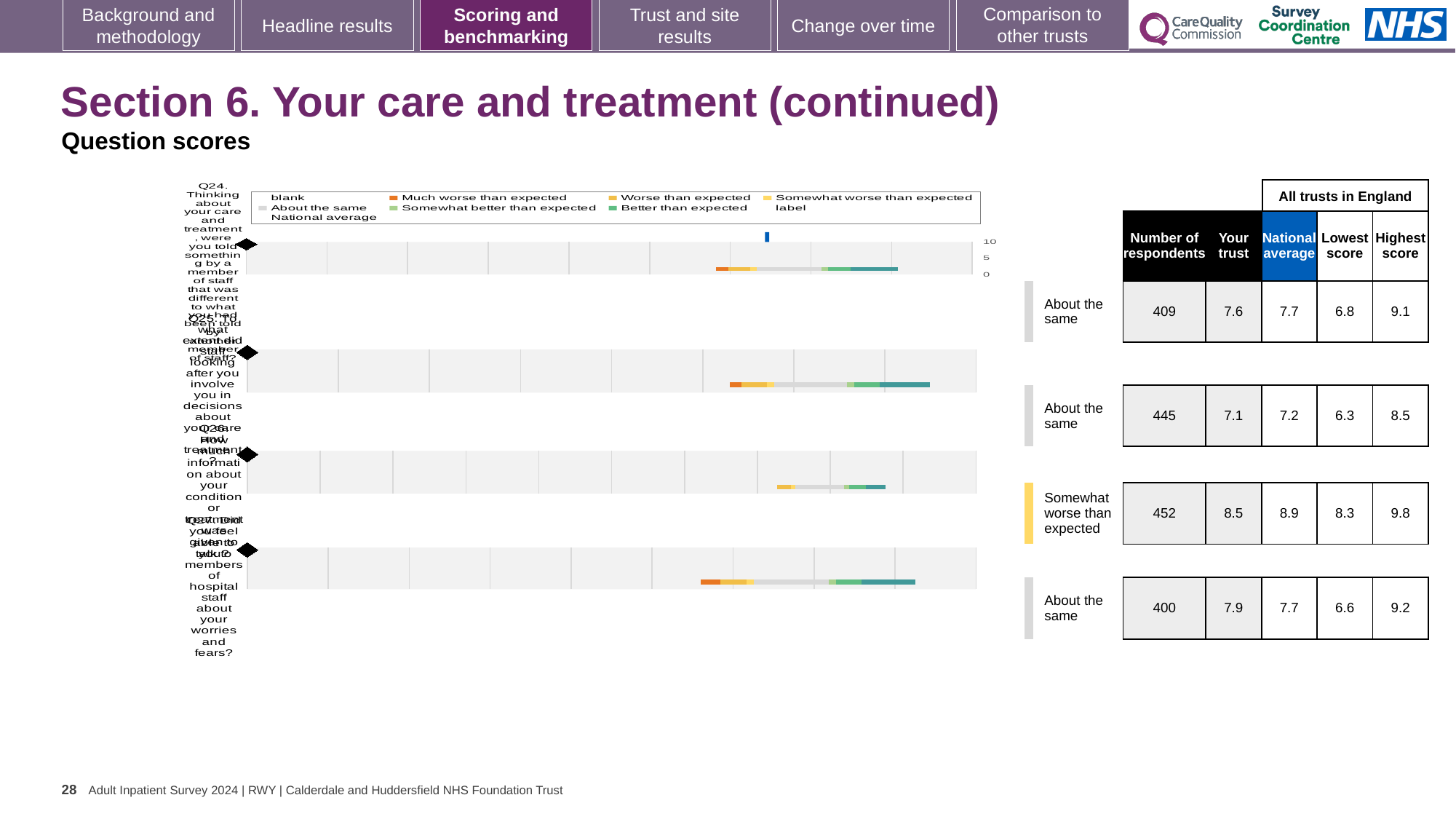
Which question has the lowest number of respondents on this slide? Q27 What is the highest score among all trusts in England for Q26 (How much information about your condition or treatment was given to you)? 9.8 How many respondents are shown for Q24 (Thinking about your care and treatment, were you told something by a member of staff that was different to what you had been told by another member of staff)? 409 Which question has the highest 'Your trust' score on this slide? Q26 Which benchmark category is Q26 placed in? Somewhat worse than expected What is the 'Your trust' score for Q24? 7.6 For Q24, which is larger: the 'Your trust' score or the national average? National average What kind of chart is used for each question on this slide? Bar chart What is the lowest score among all trusts in England for Q27 (Did you feel able to talk to members of hospital staff about your worries and fears)? 6.6 How many question charts are shown on this slide? 4 What is the national average score for Q25 (To what extent did staff looking after you involve you in decisions about your care and treatment)? 7.2 For Q26, what is the difference between the national average and the 'Your trust' score? 0.4